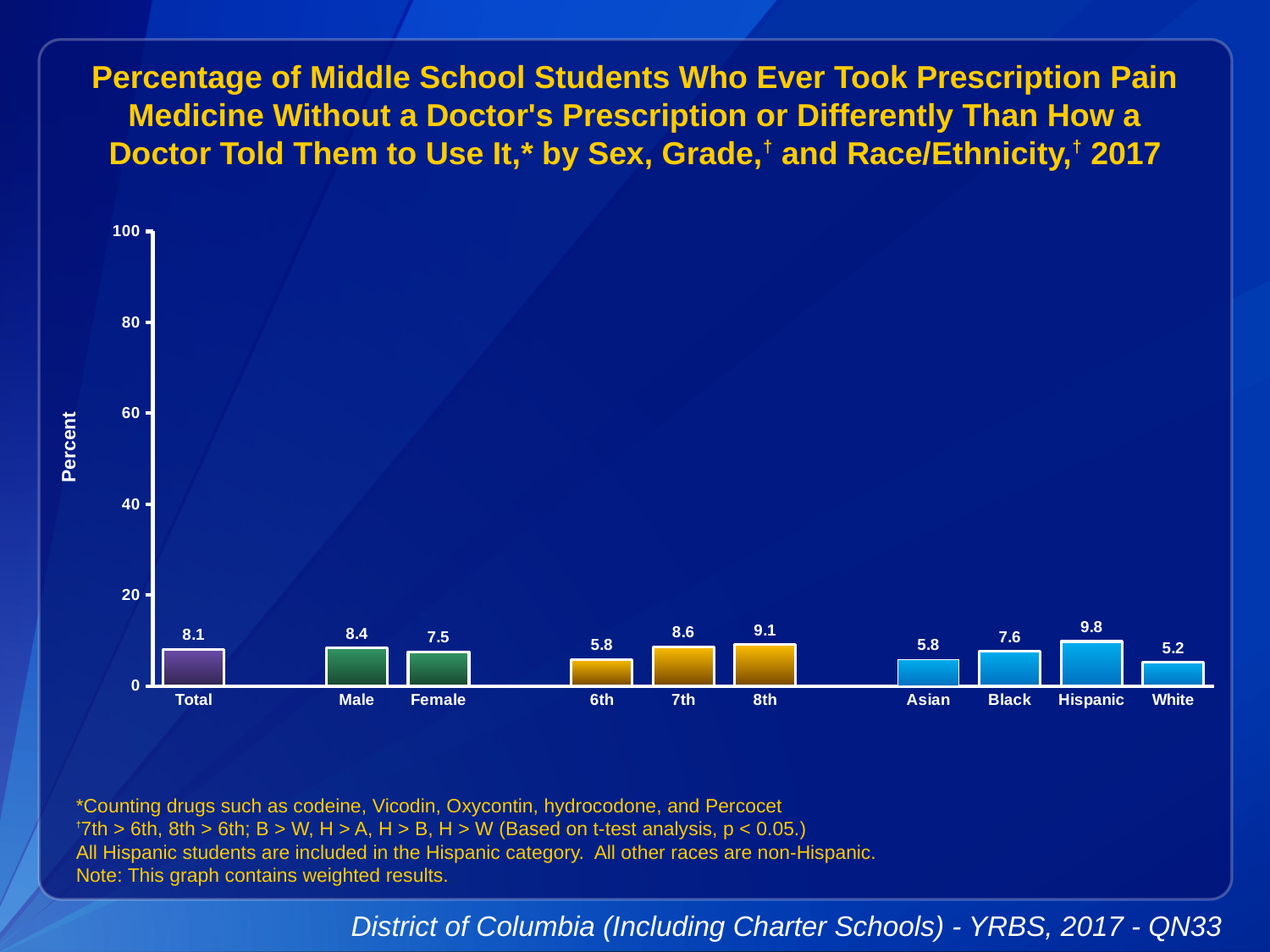
What is the value for Total? 8.1 What is the difference between the Male and Female values? 0.9 Which category has the highest value? Hispanic Which is larger, the value for 8th grade or the value for 7th grade? 8th How many categories are shown on the x axis? 10 What is the label of the y axis? Percent What kind of chart is this? bar chart Do the values rise or fall from 6th grade to 8th grade? rise Which category has the lowest value? White What is the value for Hispanic? 9.8 What is the value for 6th grade? 5.8 Is the value for Black greater or less than 20? less